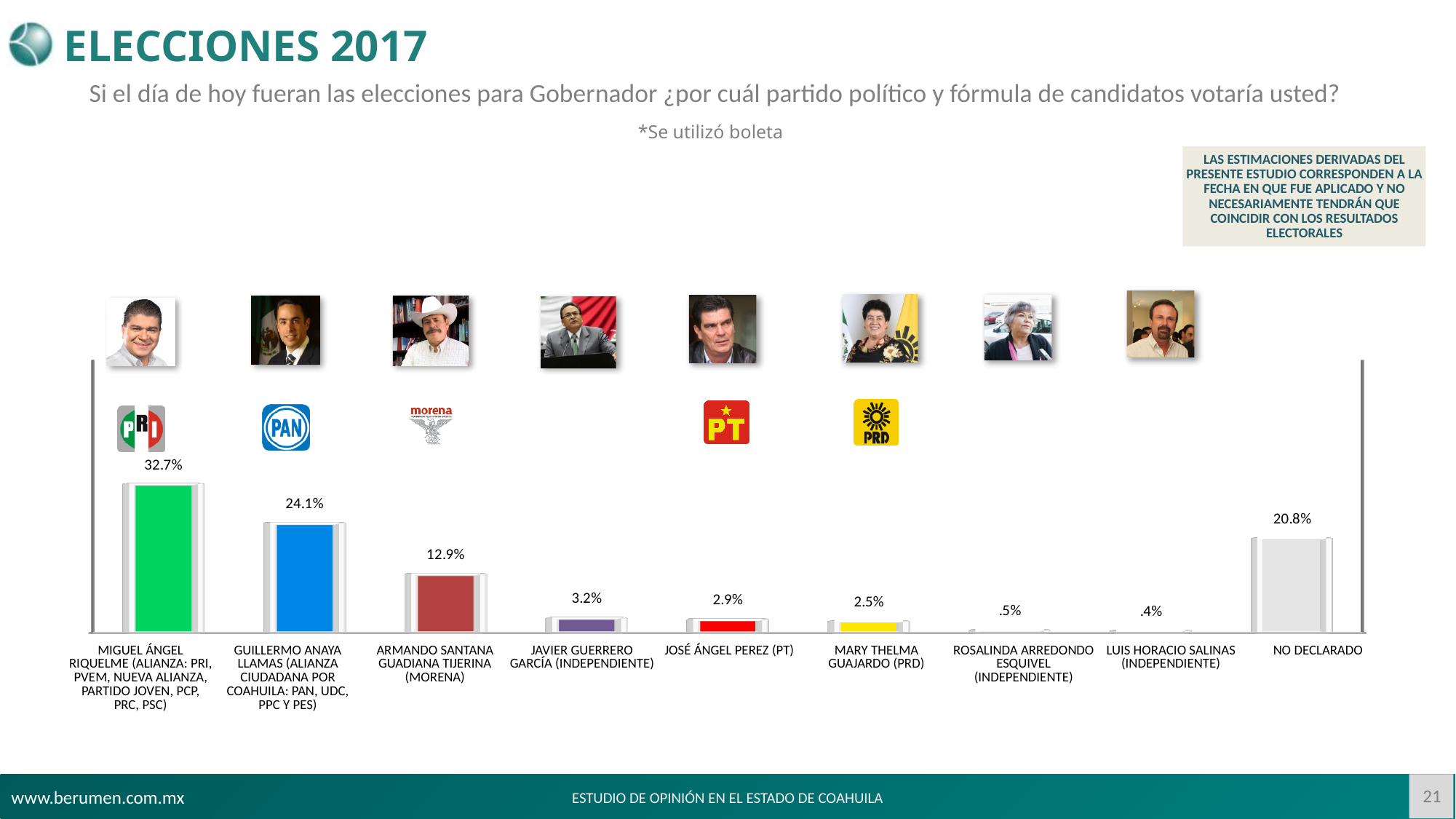
Which category has the lowest value? Luis Horacio Salinas (Independiente) What is the value for Miguel Ángel Riquelme? 32.7% What kind of chart is shown on the slide? Bar chart What is the value for Guillermo Anaya Llamas? 24.1% What is the value for No Declarado? 20.8% What is the difference between Miguel Ángel Riquelme and Guillermo Anaya Llamas? 8.6% What is the value for Luis Horacio Salinas (Independiente)? .4% What is the difference between José Ángel Perez (PT) and Mary Thelma Guajardo (PRD)? 0.4% What is the value for Armando Santana Guadiana Tijerina (Morena)? 12.9% Which is larger, the value for No Declarado or the value for Armando Santana Guadiana Tijerina? No Declarado How many categories are shown on the chart? 9 Which candidate has the highest value? Miguel Ángel Riquelme